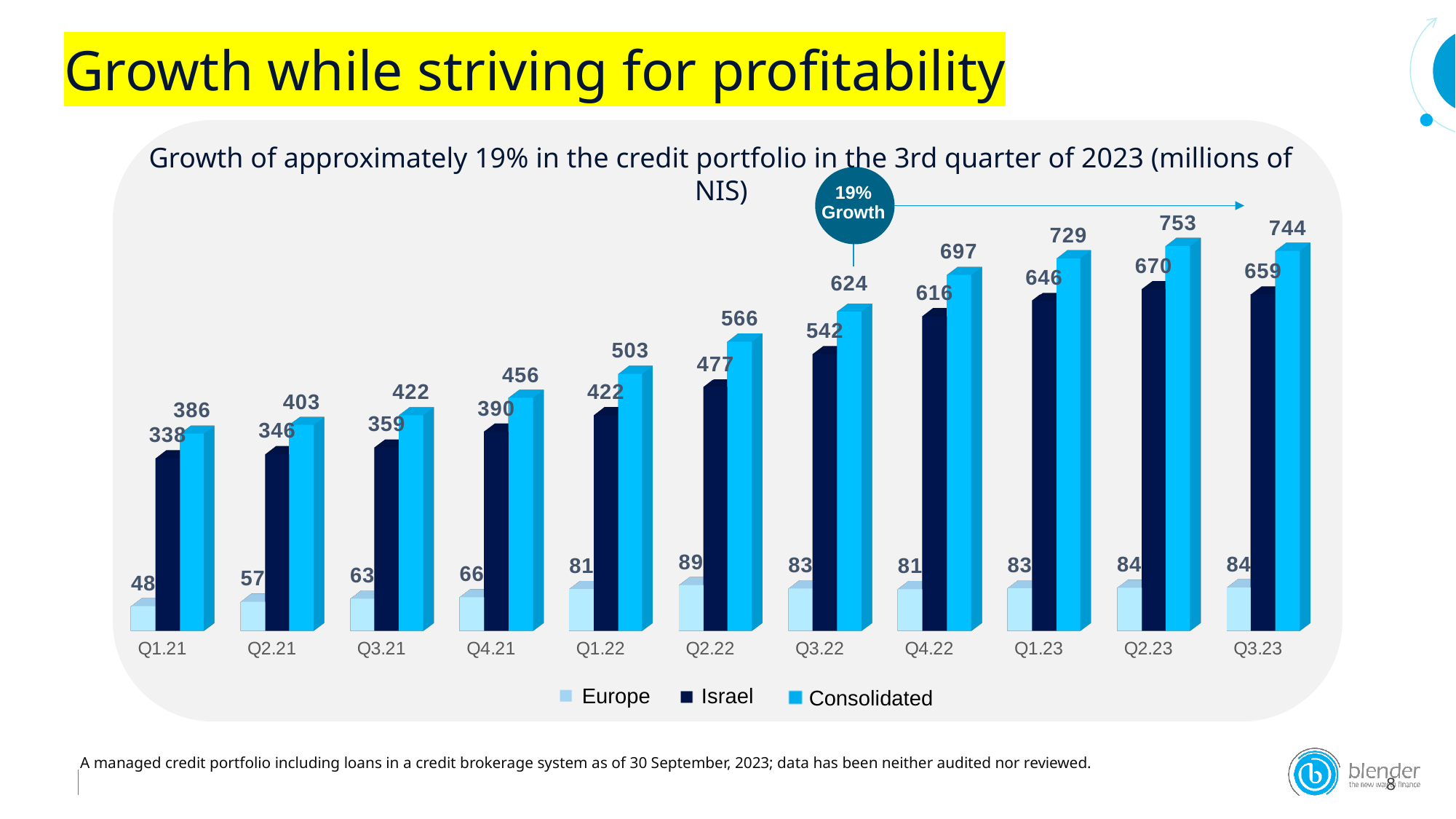
How many quarters are shown on the x axis? 11 What is the Europe value for Q2.22? 89 What is the Israel value for Q1.22? 422 In which quarter is the Consolidated value highest? Q2.23 In which quarter is the Europe value lowest? Q1.21 What kind of chart is shown on the slide? Bar chart How many series does the legend list? 3 What is the difference between the Consolidated values for Q3.23 and Q3.22? 120 What growth percentage is highlighted in the circle annotation on the chart? 19% Growth What is the Consolidated value for Q3.23? 744 Which is larger, the Israel value for Q2.23 or the Israel value for Q3.23? Q2.23 Do the Consolidated values generally rise or fall from Q1.21 to Q2.23? Rise